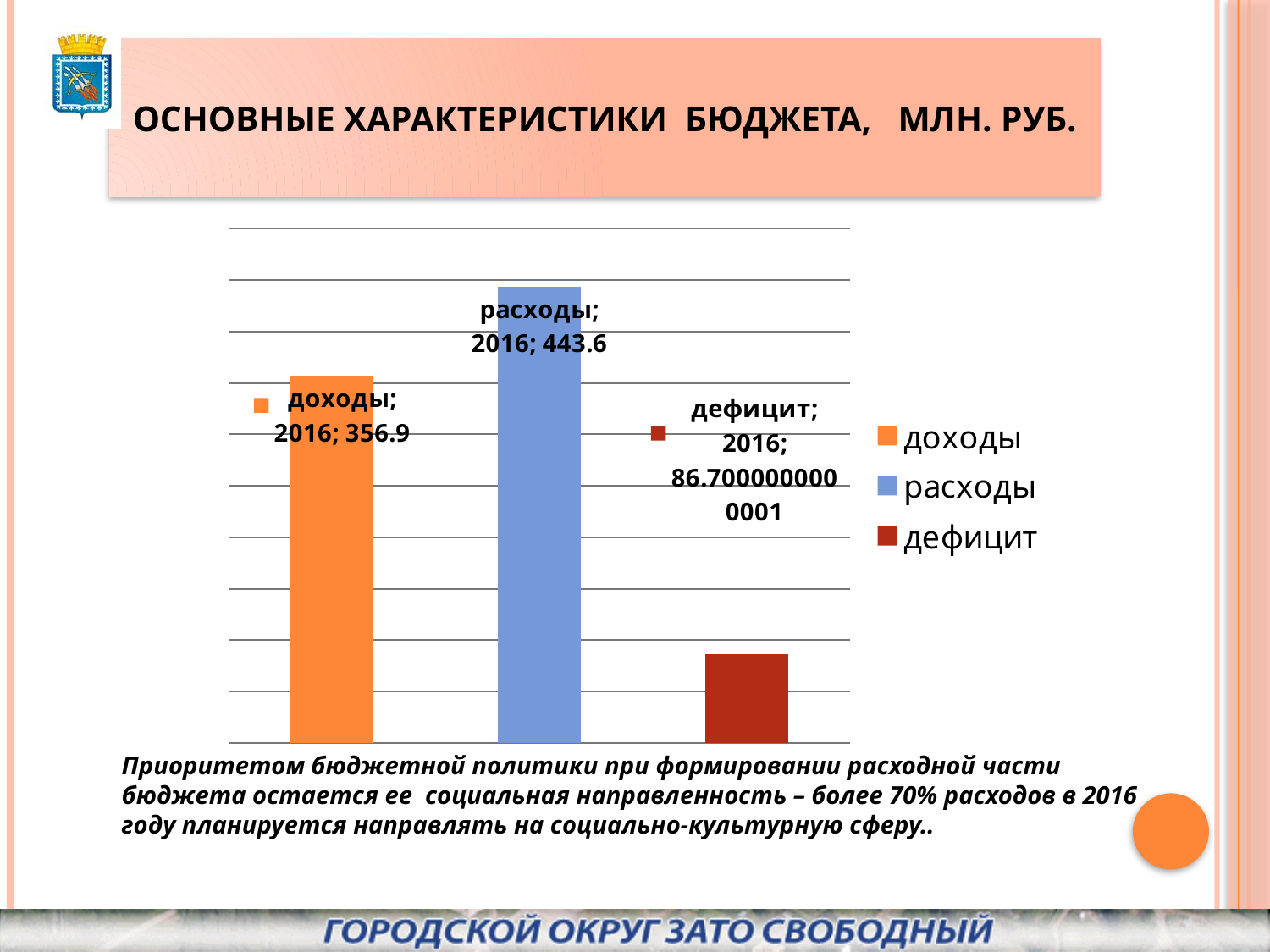
How many series does the legend list? 3 How many bars are plotted on the chart? 3 What colour is the bar for расходы? blue What kind of chart is shown on the slide? bar chart What is the difference between расходы and доходы in 2016? 86.7 Which series has the highest bar? расходы What value is printed on the data label for дефицит? 86.7000000000001 What is the value for доходы in 2016? 356.9 Which is larger, доходы or дефицит? доходы Which series has the lowest bar? дефицит What is the value for расходы in 2016? 443.6 Which is larger, доходы or расходы? расходы